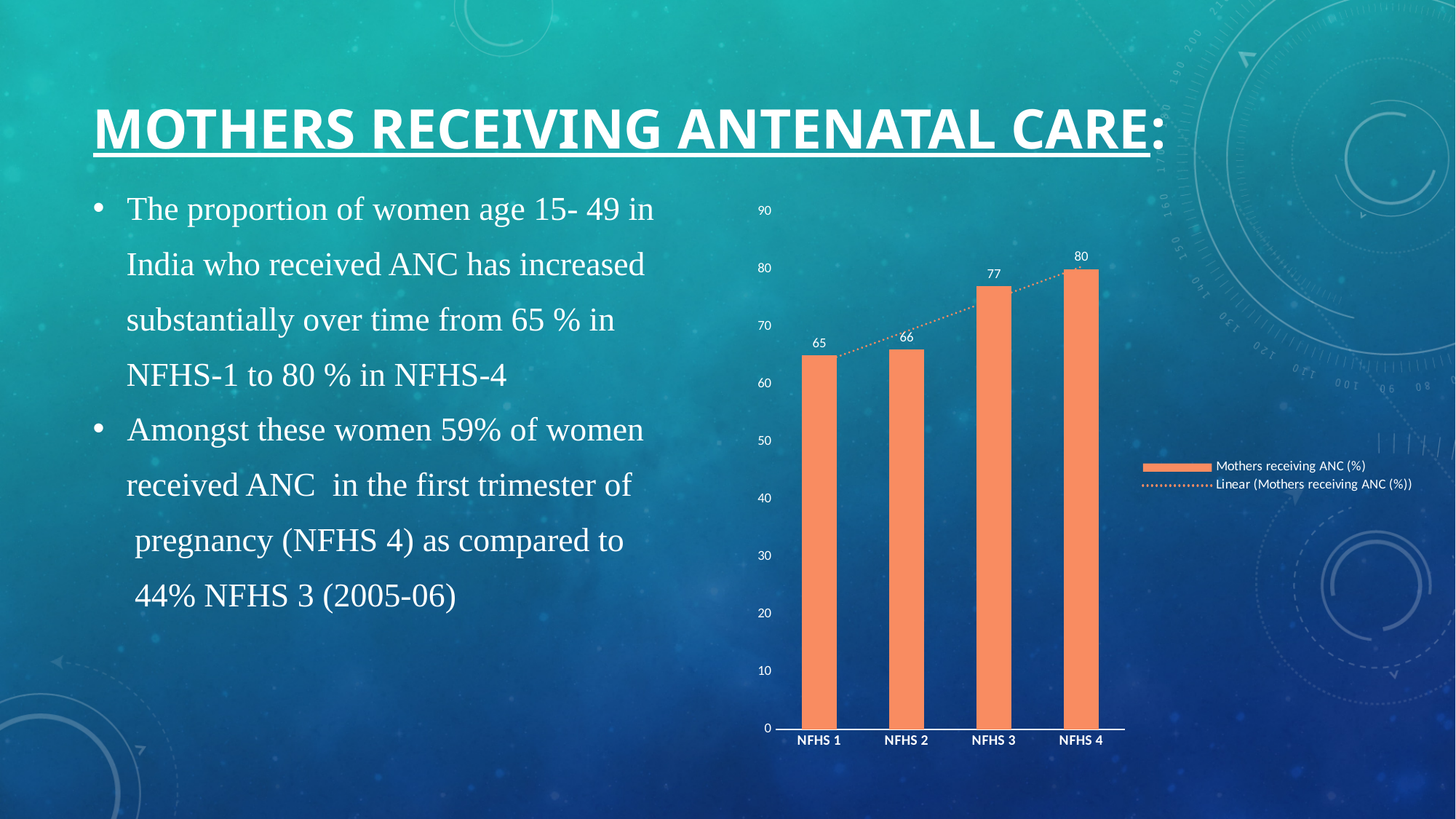
What is the value for NFHS 3 in the chart? 77 Which is larger, the value for NFHS 3 or the value for NFHS 2? NFHS 3 Which category has the lowest value in the chart? NFHS 1 How many categories are shown on the x axis of the chart? 4 What is the difference between the values for NFHS 4 and NFHS 1? 15 Do the values rise or fall from NFHS 1 to NFHS 4? Rise What kind of chart is shown on the slide? Bar chart What is the first entry in the chart's legend? Mothers receiving ANC (%) What is the difference between the values for NFHS 3 and NFHS 2? 11 What is the value for NFHS 1 in the chart? 65 Which category has the highest value in the chart? NFHS 4 What is the value for NFHS 4 in the chart? 80